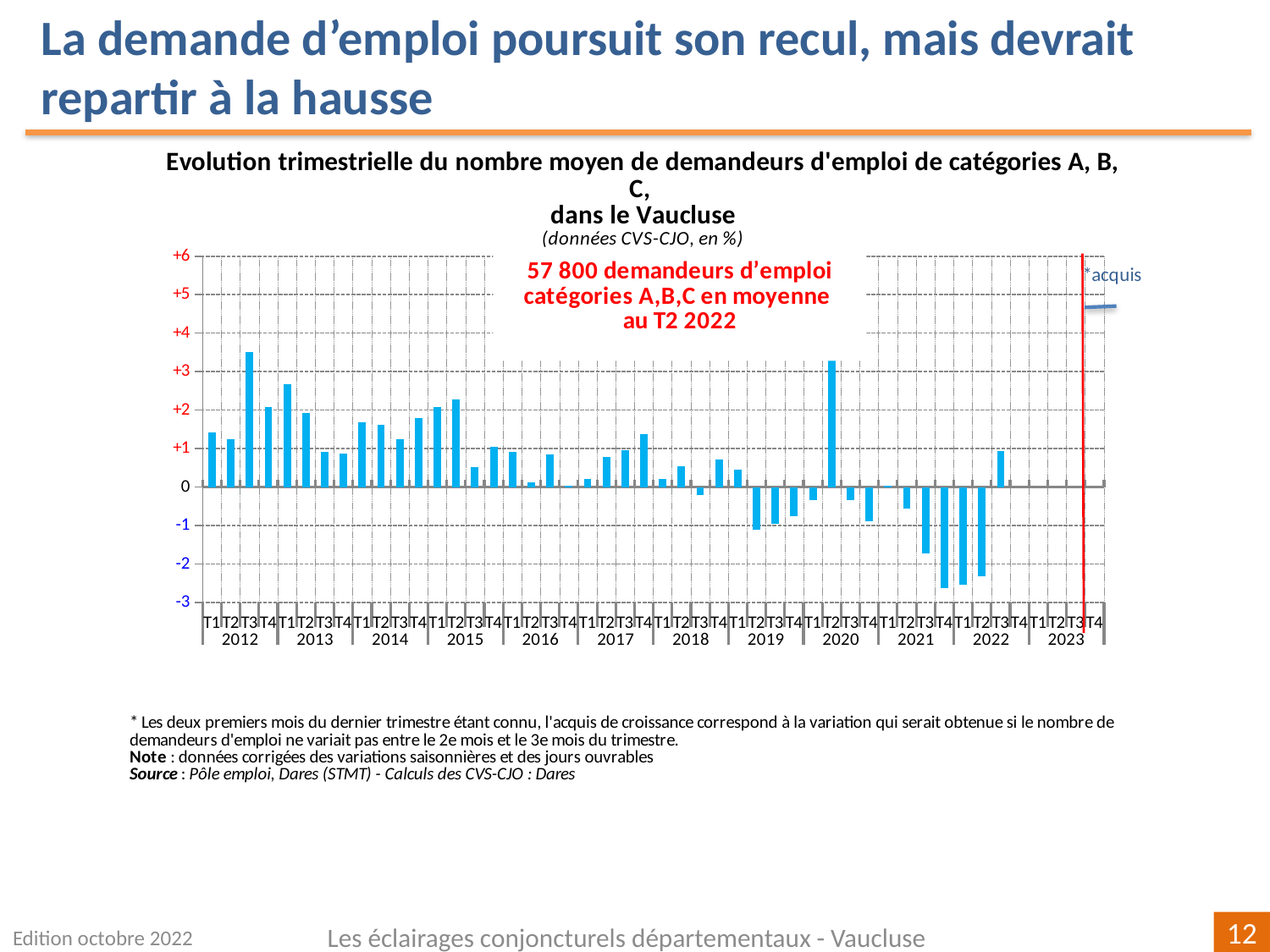
What kind of chart is shown on the slide? bar chart From T1 2019 to T2 2019, does the value rise or fall? fall Is the value for T3 2012 greater or less than +3? greater In what unit are the data in the chart expressed, according to the subtitle? en % Is the value for T1 2013 greater or less than +2? greater How many years are labelled on the x axis of the chart? 12 Is the value for T2 2020 greater or less than +2? greater Which is larger, the value for T3 2012 or the value for T1 2013? T3 2012 According to the red annotation on the chart, how many job seekers in categories A, B, C were there on average in T2 2022? 57 800 Which is lower, the value for T2 2021 or the value for T3 2021? T3 2021